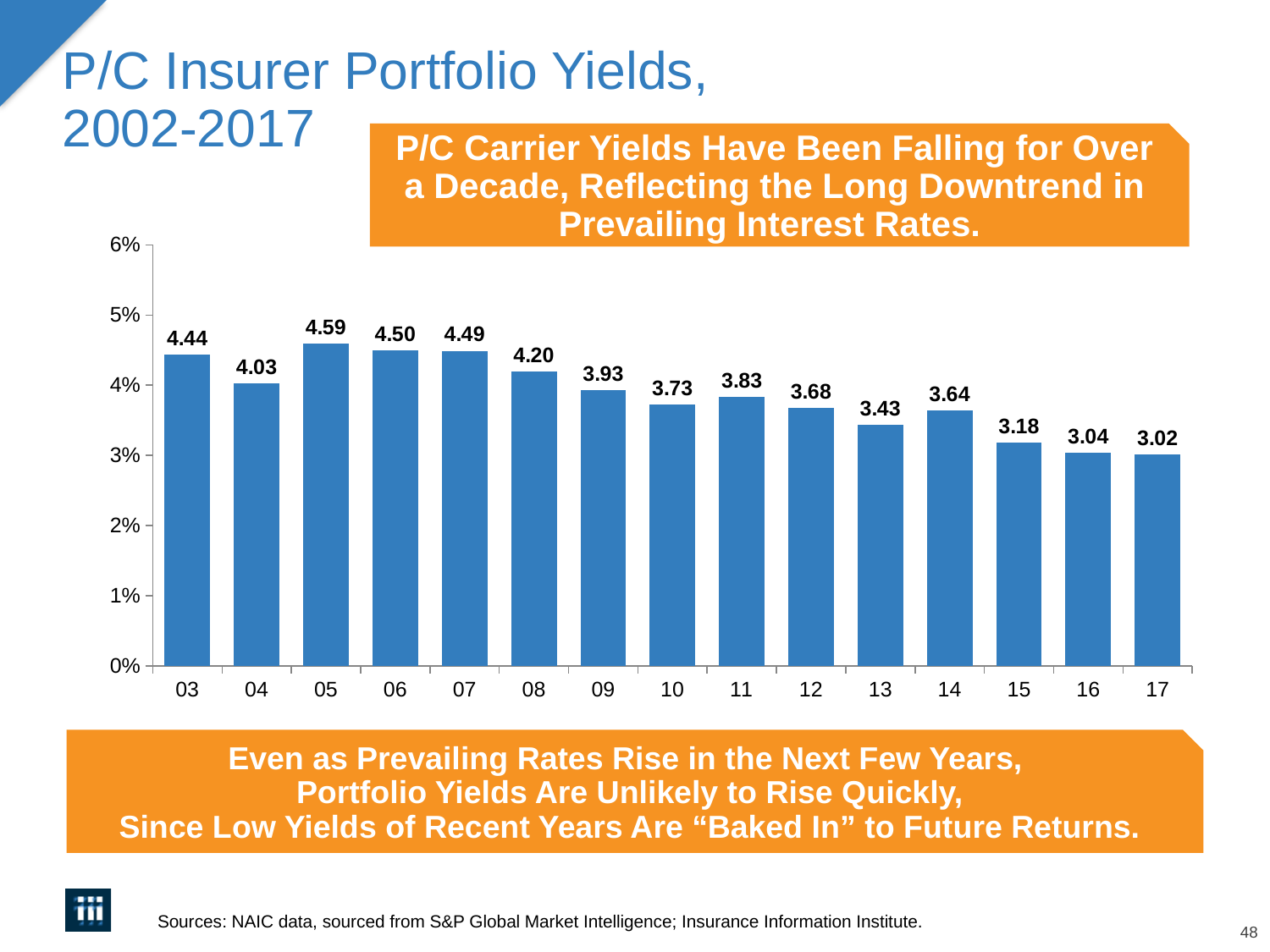
What value is labeled on the bar for 2013? 3.43 What is the P/C insurer portfolio yield shown for 2005? 4.59 Which year has a higher yield, 2011 or 2012? 11 Is the value for 2015 greater or less than 3%? greater Do the portfolio yields generally rise or fall from 2003 to 2017? Fall How many years (bars) are plotted on the chart? 15 Which year has the lowest portfolio yield on the chart? 17 What is the title of the slide's chart? P/C Insurer Portfolio Yields, 2002-2017 Which year has the highest portfolio yield on the chart? 05 What kind of chart is shown on the slide? Bar chart What is the portfolio yield shown for 2017? 3.02 What is the difference between the yield in 2003 (4.44) and the yield in 2004 (4.03)? 0.41